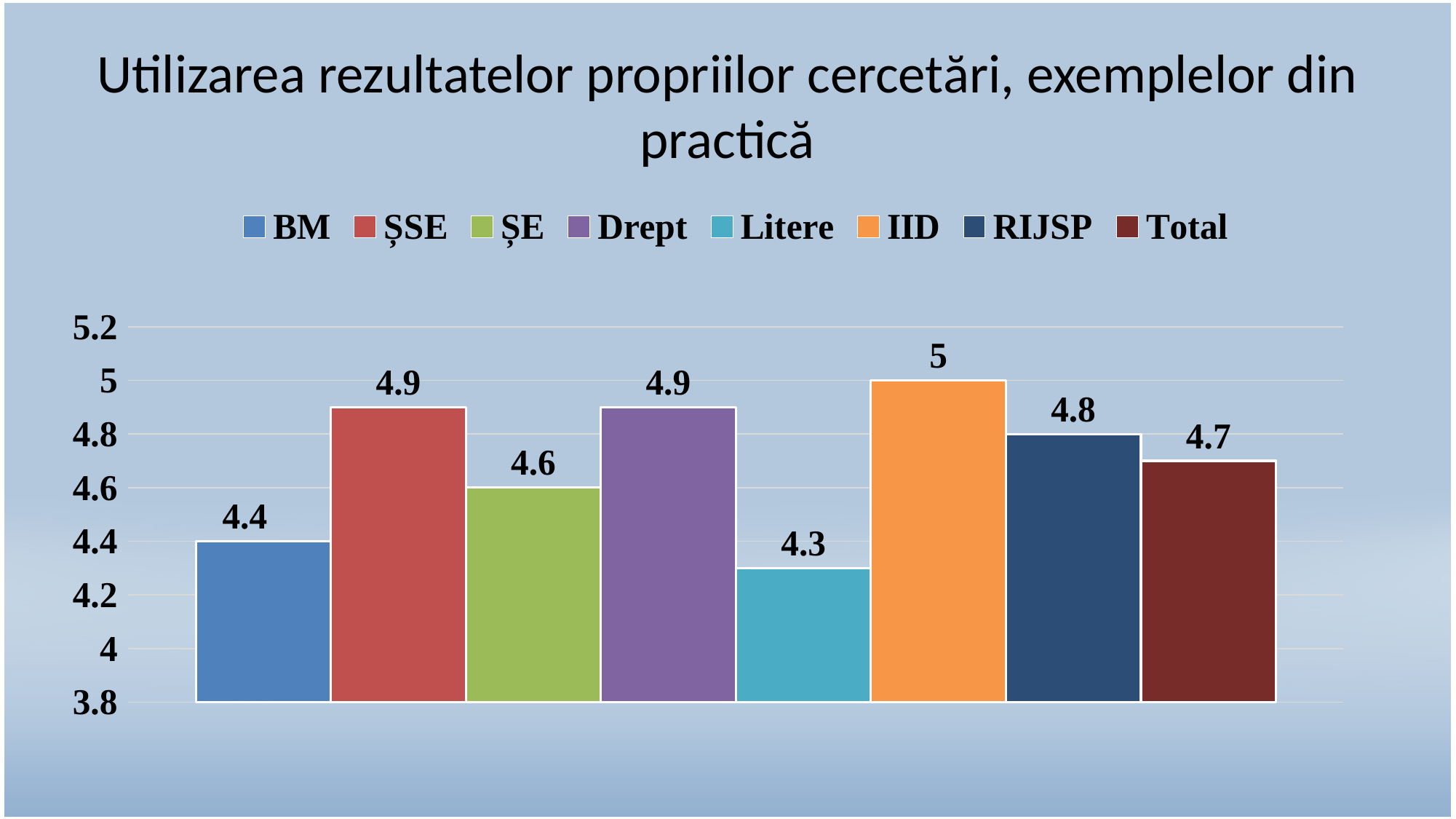
What is the value for BM? 4.4 Which series has the lowest value? Litere Which is larger, the value for ȘE or the value for Drept? Drept Which series has the highest value? IID What is the difference between the values for RIJSP and BM? 0.4 How many series does the legend list? 8 What is the value for Total? 4.7 What is the value for Litere? 4.3 What is the title of the chart? Utilizarea rezultatelor propriilor cercetări, exemplelor din practică What is the value for IID? 5 What is the difference between the values for IID and Litere? 0.7 What kind of chart is shown on the slide? Bar chart